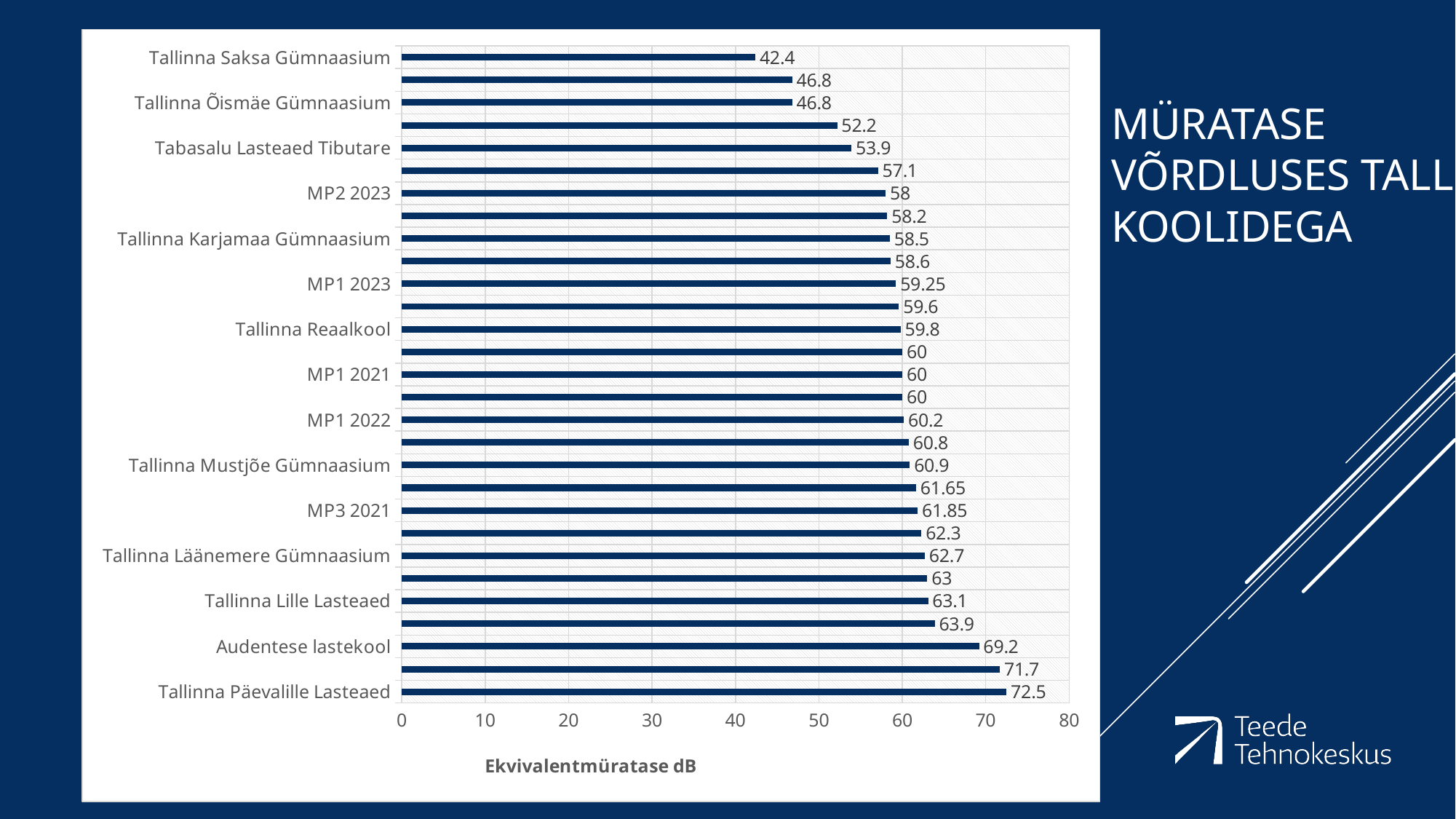
Which labelled category has the highest value? Tallinna Päevalille Lasteaed What is the value for Tallinna Saksa Gümnaasium? 42.4 What is the value for MP1 2023? 59.25 What is the value for Tabasalu Lasteaed Tibutare? 53.9 What is the value for Tallinna Päevalille Lasteaed? 72.5 What kind of chart is shown on the slide? bar chart Which is larger, the value for Audentese lastekool or the value for Tallinna Lille Lasteaed? Audentese lastekool Is the value for Tallinna Õismäe Gümnaasium greater or less than 50? less What is the difference between the values for Tallinna Päevalille Lasteaed and Tallinna Saksa Gümnaasium? 30.1 Which labelled category has the lowest value? Tallinna Saksa Gümnaasium What is the x-axis title of the chart? Ekvivalentmüratase dB What is the value for Audentese lastekool? 69.2